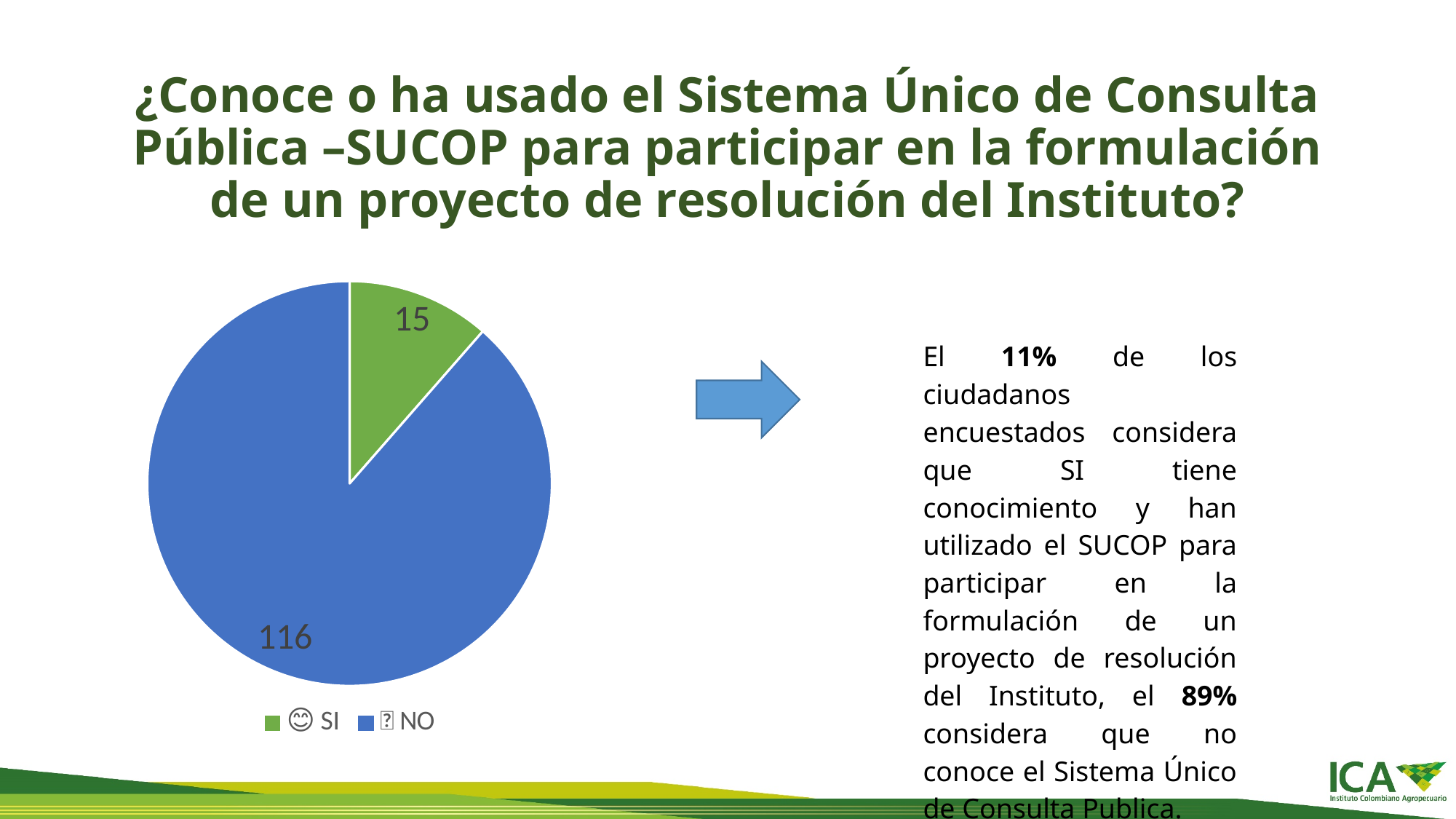
Which is larger in the pie chart, the value for SI or the value for NO? NO Which category has the largest slice in the pie chart? NO What colour is the NO slice in the pie chart? blue What is the total of the two values shown in the pie chart? 131 According to the slide, what percentage of respondents answered NO? 89% Which category has the smallest slice in the pie chart? SI What is the value for the SI slice of the pie chart? 15 According to the slide, what percentage of respondents answered SI? 11% How many slices does the pie chart have? 2 What kind of chart is shown on the slide? pie chart What is the difference between the NO value and the SI value in the pie chart? 101 What is the value for the NO slice of the pie chart? 116